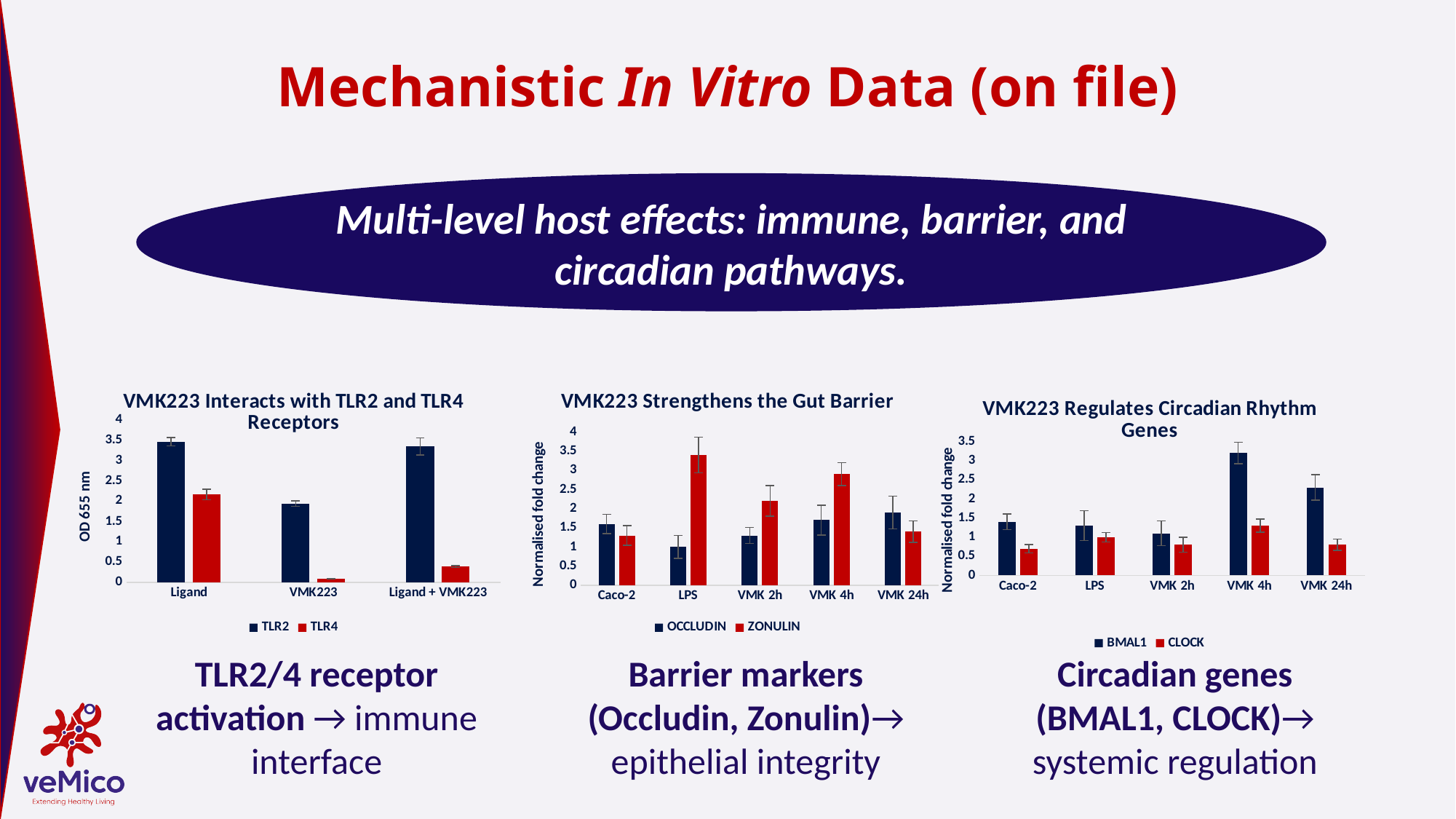
In the chart titled 'VMK223 Regulates Circadian Rhythm Genes', which category has the highest BMAL1 value? VMK 4h In the chart titled 'VMK223 Strengthens the Gut Barrier', which category has the highest ZONULIN value? LPS In the chart titled 'VMK223 Interacts with TLR2 and TLR4 Receptors', how many series does the legend list? 2 In the chart titled 'VMK223 Regulates Circadian Rhythm Genes', is the BMAL1 value for VMK 24h greater or less than 2? greater In the chart titled 'VMK223 Interacts with TLR2 and TLR4 Receptors', what is the y-axis label? OD 655 nm What type of chart is the one titled 'VMK223 Regulates Circadian Rhythm Genes'? Bar chart In the chart titled 'VMK223 Interacts with TLR2 and TLR4 Receptors', is the TLR2 value for Ligand greater or less than 3? greater In the chart titled 'VMK223 Strengthens the Gut Barrier', which is larger for VMK 24h: OCCLUDIN or ZONULIN? OCCLUDIN In the chart titled 'VMK223 Interacts with TLR2 and TLR4 Receptors', which is larger for the VMK223 category: TLR2 or TLR4? TLR2 In the chart titled 'VMK223 Strengthens the Gut Barrier', how many categories are shown on the x axis? 5 In the chart titled 'VMK223 Interacts with TLR2 and TLR4 Receptors', which category has the lowest TLR4 value? VMK223 In the chart titled 'VMK223 Strengthens the Gut Barrier', is the ZONULIN value for LPS greater or less than 3? greater